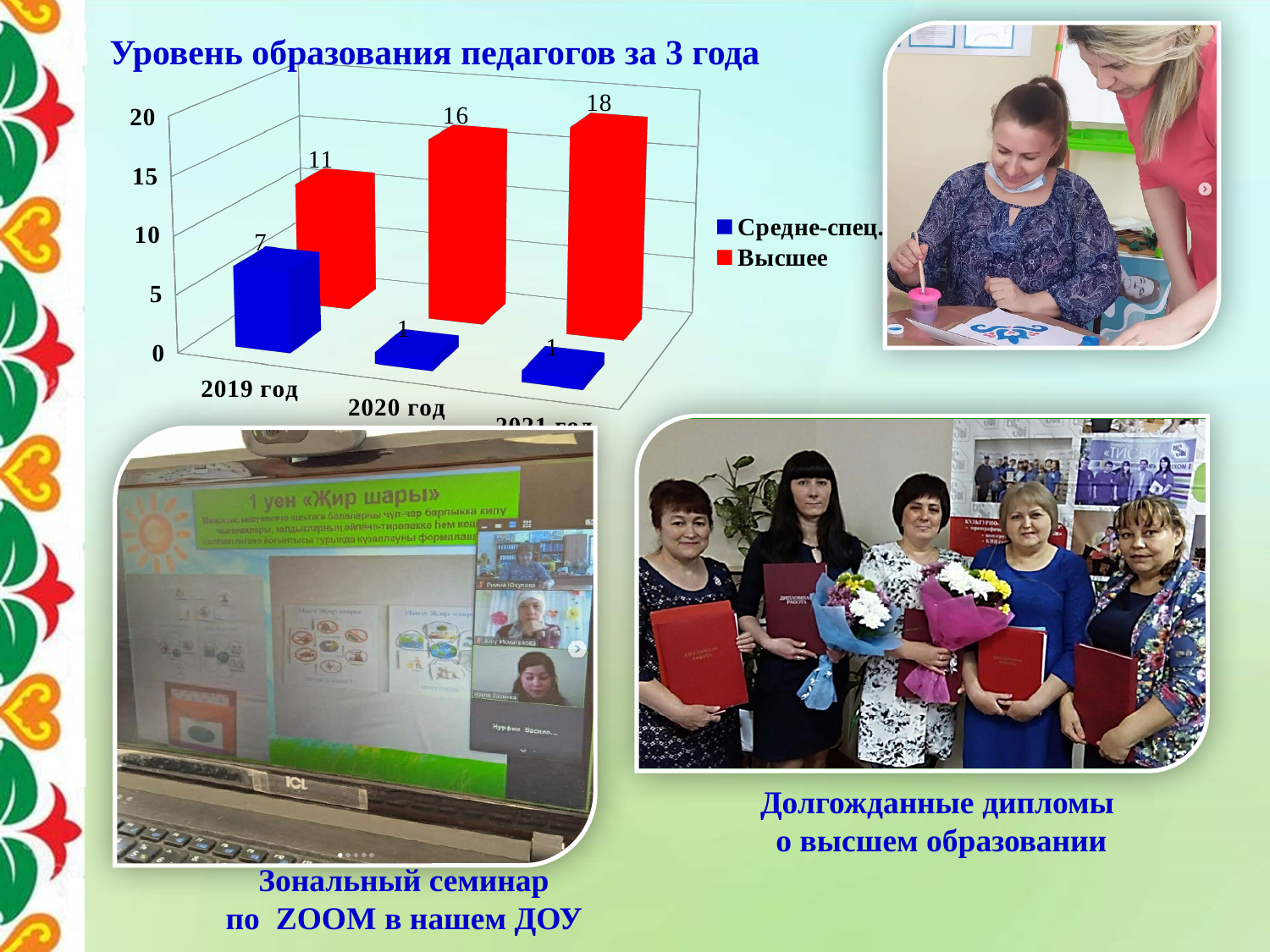
What is the value for Средне-спец. in 2020 год? 1 How many years are shown on the x axis of the chart? 3 In which year is the value for Высшее the highest? 2021 год In which year is the value for Средне-спец. the highest? 2019 год How many series does the chart legend list? 2 What is the difference between Высшее and Средне-спец. in 2020 год? 15 What is the value for Средне-спец. in 2019 год? 7 What is the value for Высшее in 2019 год? 11 Which is larger in 2019 год, Высшее or Средне-спец.? Высшее Does the value for Высшее rise or fall from 2019 год to 2021 год? rise What is the value for Высшее in 2021 год? 18 What kind of chart is shown on the slide? bar chart